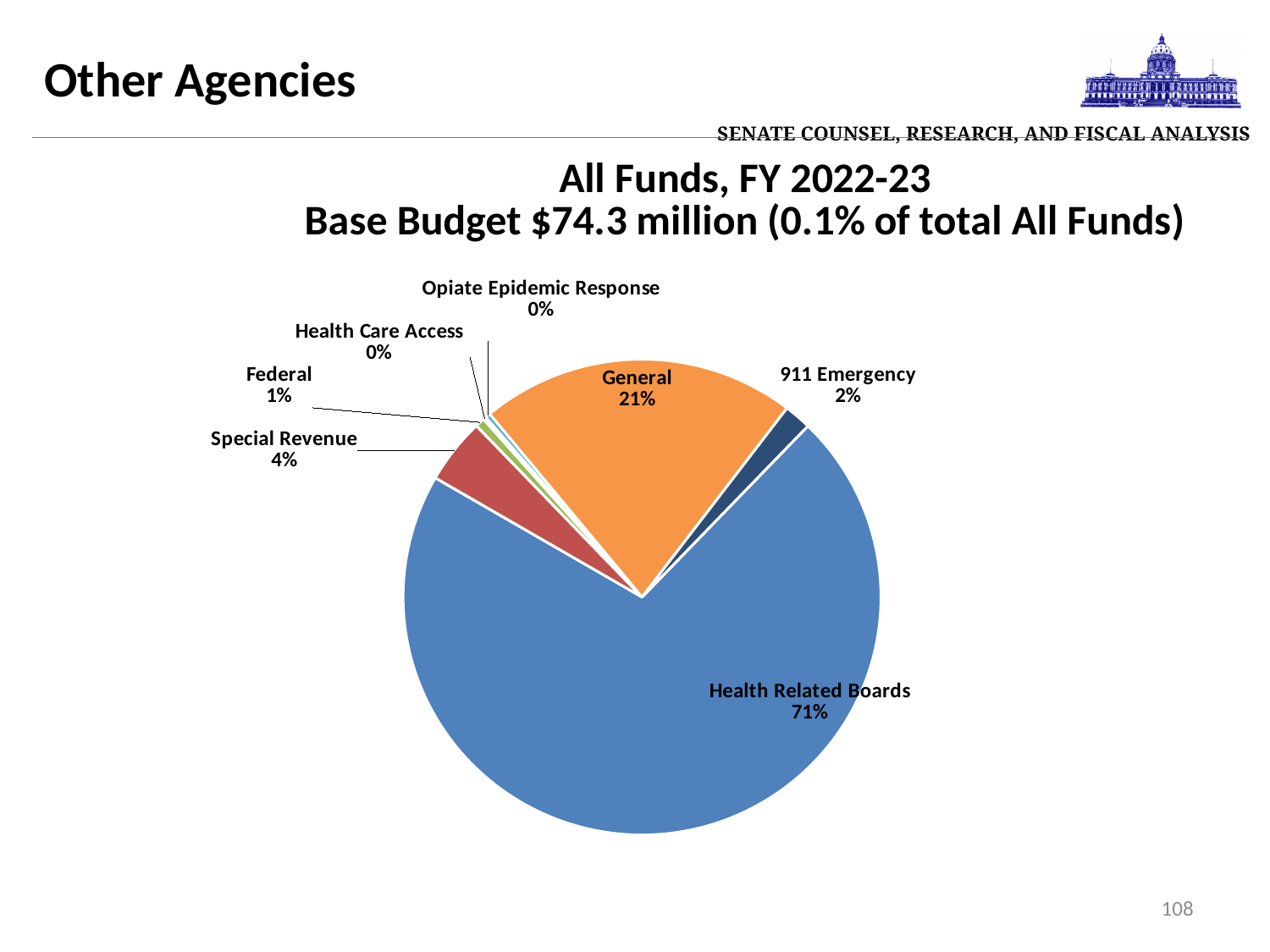
Which category has the largest slice of the pie? Health Related Boards What share of the pie does Health Related Boards represent? 71% What share of the pie does Federal represent? 1% What share of the pie does General represent? 21% How many slices are labelled on the pie chart? 7 What is the difference in percentage points between Health Related Boards and General? 50 percentage points What colour is the Health Related Boards slice? blue Which is larger, the Special Revenue slice or the 911 Emergency slice? Special Revenue What is the title of the chart? All Funds, FY 2022-23 Base Budget $74.3 million (0.1% of total All Funds) What kind of chart is shown on the slide? pie chart